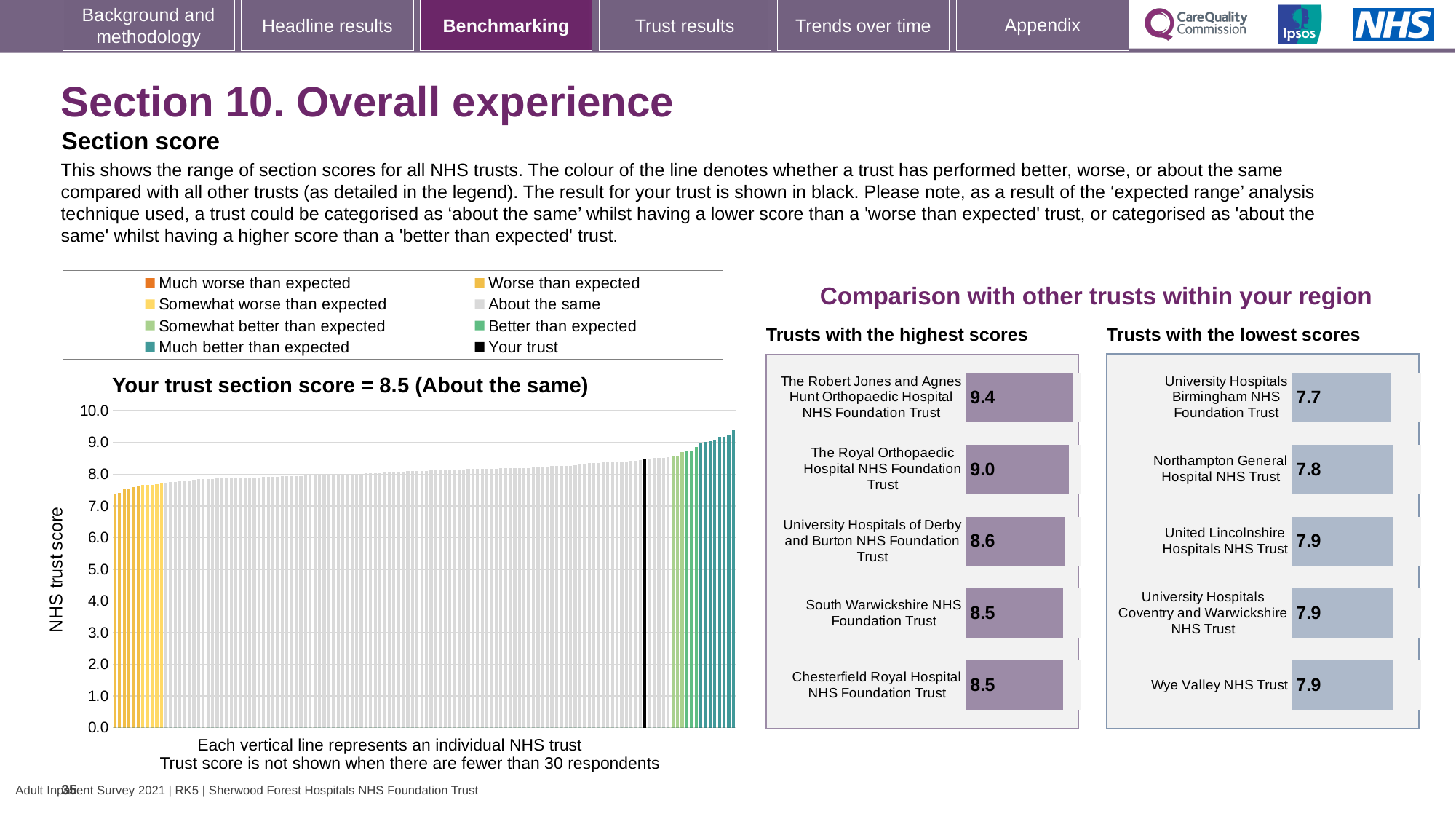
On the 'Your trust section score' chart, what is the section score for your trust? 8.5 On the 'Trusts with the lowest scores' chart, which trust has the lowest score? University Hospitals Birmingham NHS Foundation Trust On the 'Trusts with the highest scores' chart, what is the score for The Royal Orthopaedic Hospital NHS Foundation Trust? 9.0 On the 'Trusts with the highest scores' chart, which trust has the highest score? The Robert Jones and Agnes Hunt Orthopaedic Hospital NHS Foundation Trust On the 'Trusts with the lowest scores' chart, which has the larger score: Wye Valley NHS Trust or University Hospitals Birmingham NHS Foundation Trust? Wye Valley NHS Trust On the 'Trusts with the lowest scores' chart, what is the score for Northampton General Hospital NHS Trust? 7.8 How many entries does the legend above the 'Your trust section score' chart list? 8 On the 'Your trust section score' chart, do the trust scores rise or fall from left to right along the x axis? rise On the 'Your trust section score' chart, what is the label on the vertical axis? NHS trust score On the 'Your trust section score' chart, what kind of chart is shown? bar chart On the 'Trusts with the highest scores' chart, what is the difference between the scores of The Robert Jones and Agnes Hunt Orthopaedic Hospital NHS Foundation Trust and University Hospitals of Derby and Burton NHS Foundation Trust? 0.8 How many trusts are shown on the 'Trusts with the highest scores' chart? 5